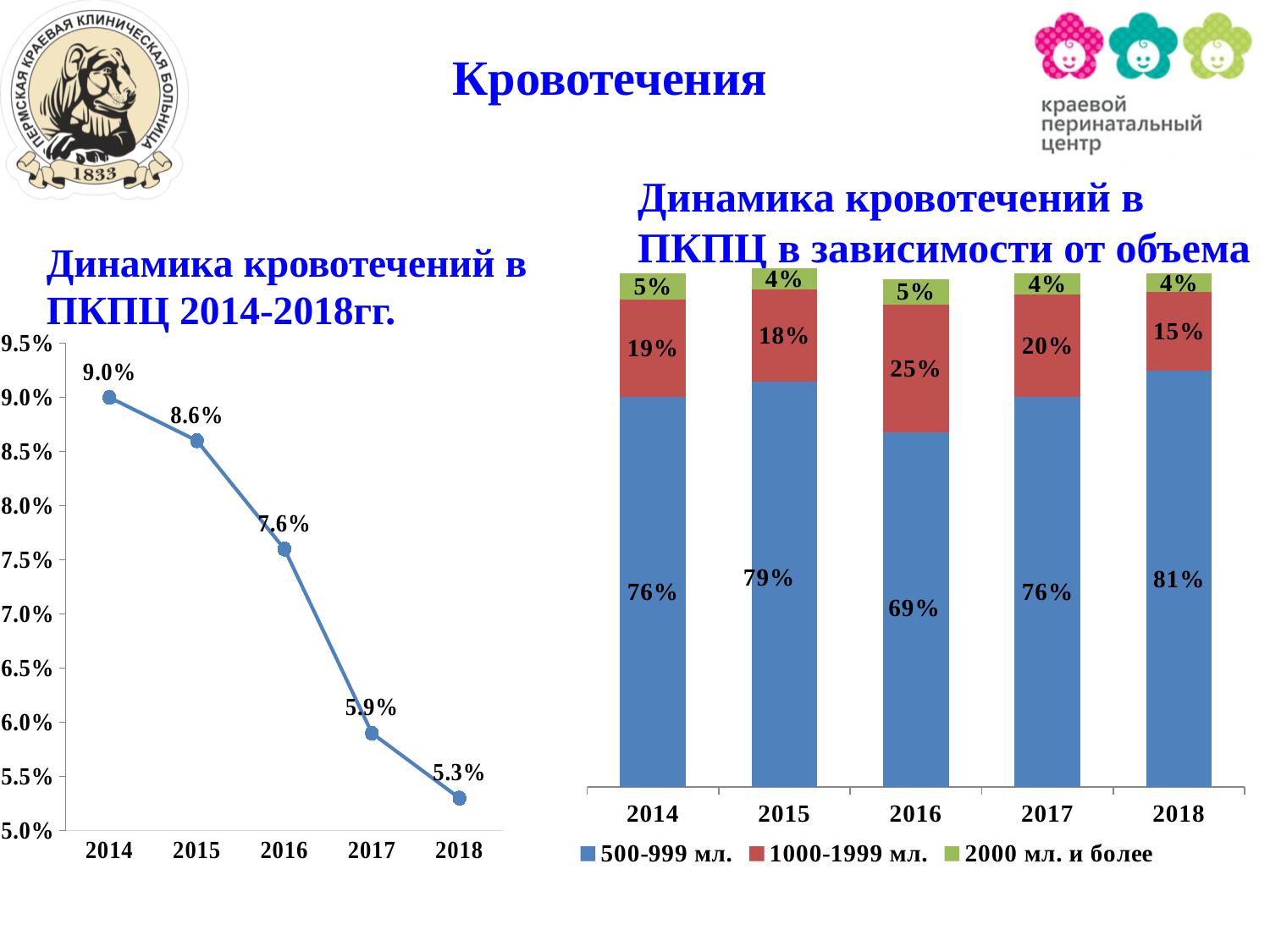
In the right chart 'Динамика кровотечений в ПКПЦ в зависимости от объема', which year has the highest value for '500-999 мл.'? 2018 What kind of chart is the left chart 'Динамика кровотечений в ПКПЦ 2014-2018гг.'? line chart What kind of chart is the right chart 'Динамика кровотечений в ПКПЦ в зависимости от объема'? stacked bar chart In the left chart 'Динамика кровотечений в ПКПЦ 2014-2018гг.', what is the value for 2017? 5.9% In the left chart 'Динамика кровотечений в ПКПЦ 2014-2018гг.', what is the value for 2014? 9.0% In the right chart 'Динамика кровотечений в ПКПЦ в зависимости от объема', what is the value for '500-999 мл.' in 2016? 69% In the right chart 'Динамика кровотечений в ПКПЦ в зависимости от объема', what is the value for '1000-1999 мл.' in 2018? 15% How many series does the legend of the right chart 'Динамика кровотечений в ПКПЦ в зависимости от объема' list? 3 In the left chart 'Динамика кровотечений в ПКПЦ 2014-2018гг.', what is the difference between the 2014 and 2018 values? 3.7% In the left chart 'Динамика кровотечений в ПКПЦ 2014-2018гг.', which year has the lowest value? 2018 In the left chart 'Динамика кровотечений в ПКПЦ 2014-2018гг.', do the values rise or fall from 2014 to 2018? fall In the right chart 'Динамика кровотечений в ПКПЦ в зависимости от объема', which is larger: the '1000-1999 мл.' value in 2016 or in 2017? 2016